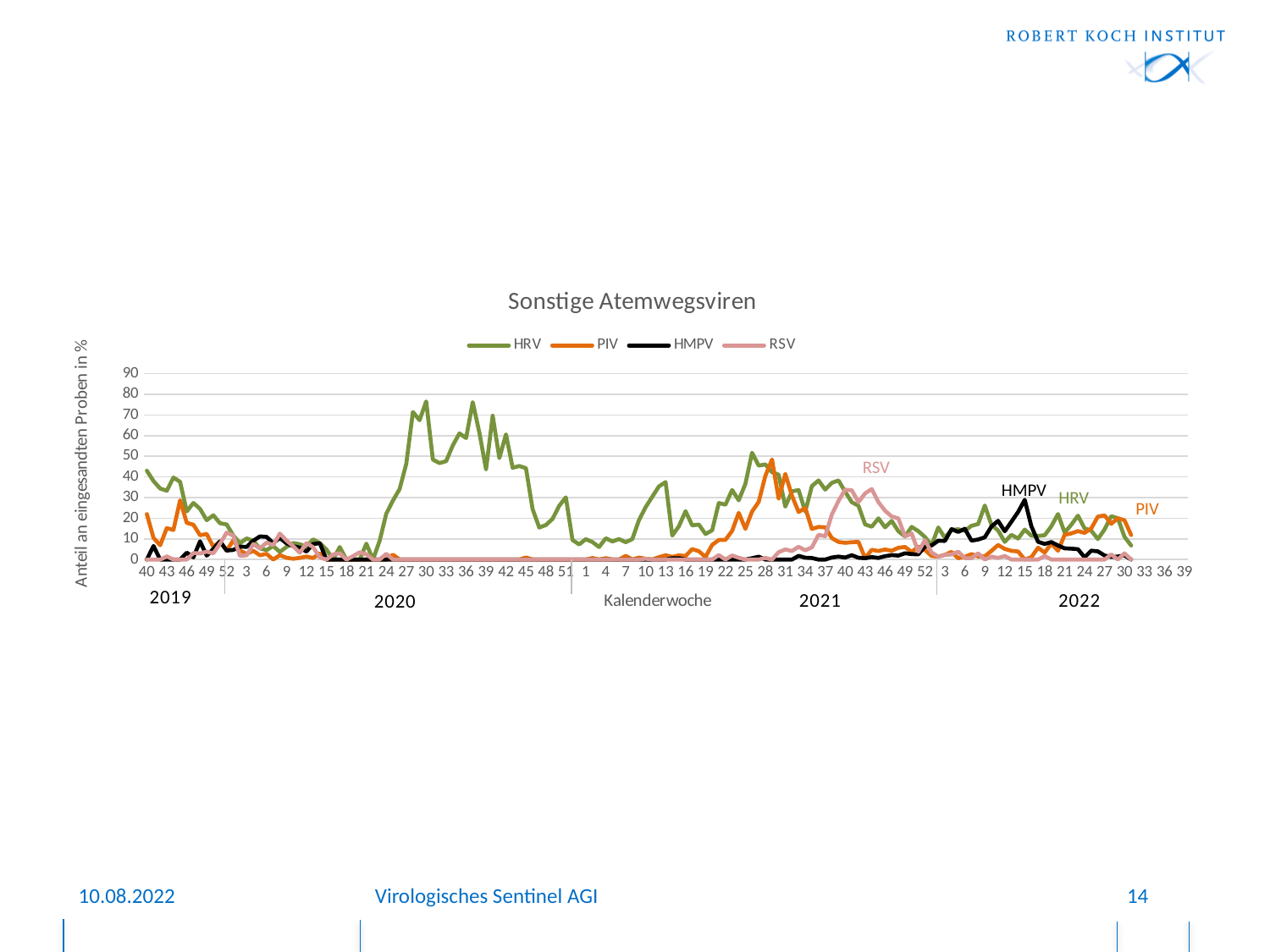
What kind of chart is shown on the slide? line chart Which series reaches the highest value anywhere on the chart? HRV How many years are labelled along the x axis? 4 Is the highest value reached by HRV in 2020 greater or less than 70? greater How many series does the legend list? 4 What is the title of the chart? Sonstige Atemwegsviren Does the HRV line rise or fall between calendar week 36 and calendar week 51 of 2020? fall Around calendar week 28 of 2021, which is larger, PIV or HMPV? PIV Is the highest value reached by HMPV in 2022 greater or less than 40? less Is the highest value reached by RSV in 2021 greater or less than 50? less What is the label of the vertical axis? Anteil an eingesandten Proben in %